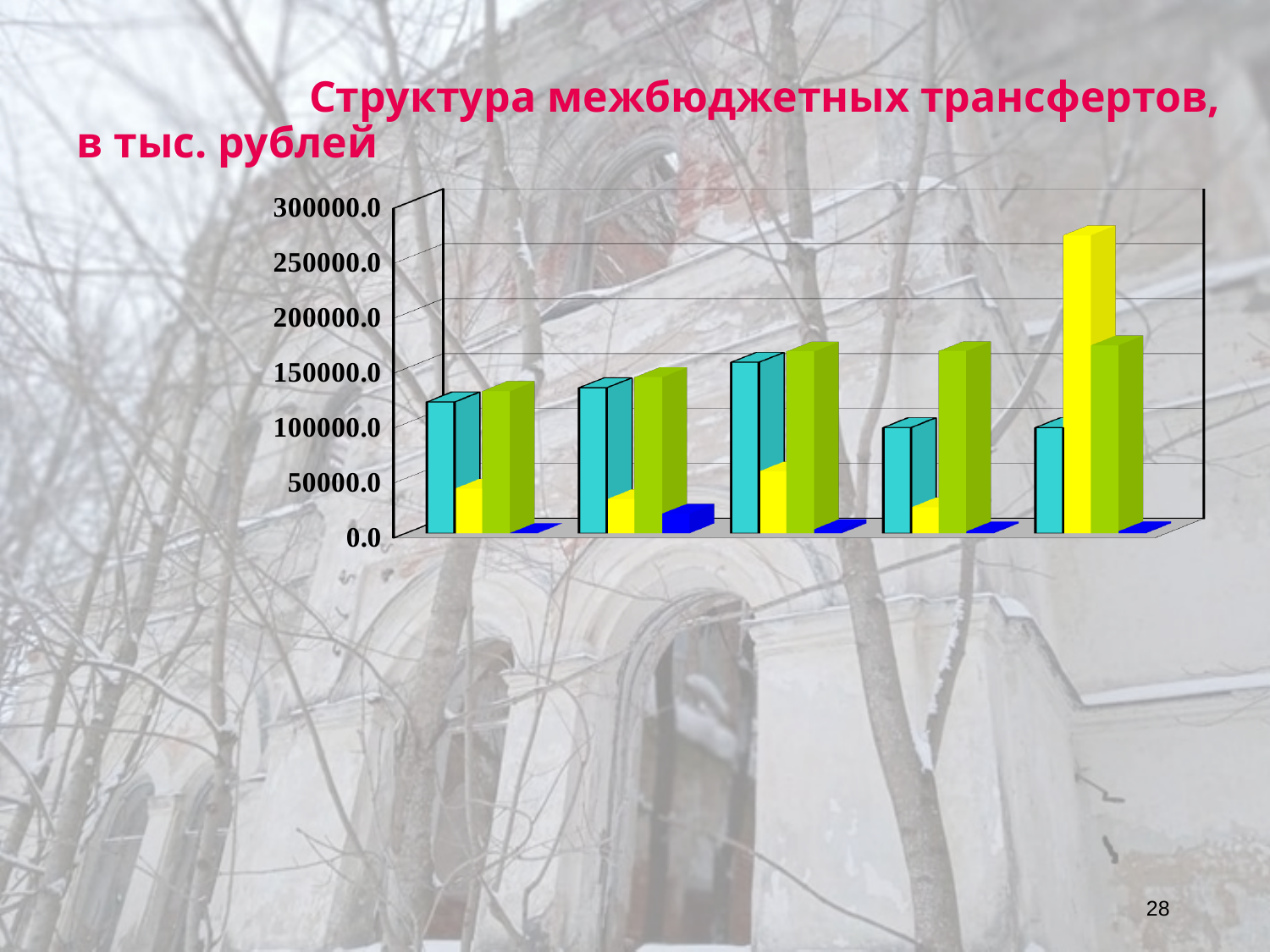
How many groups of bars are plotted in the chart? 5 What kind of chart is shown on the slide? bar chart What is the highest value labelled on the vertical axis of the chart? 300000.0 In the rightmost group, which bar is taller: the yellow bar or the green bar? the yellow bar Is the value of the yellow bar in the leftmost group greater or less than 100000? less Is the value of the cyan bar in the fourth group from the left greater or less than 150000? less Is the value of the yellow bar in the rightmost group greater or less than 250000? greater How many bars are there in each group of the chart? 4 What is the title of the chart on the slide? Структура межбюджетных трансфертов, в тыс. рублей In the leftmost group, which bar is taller: the cyan bar or the yellow bar? the cyan bar Which group of bars contains the tallest bar in the chart? the rightmost (fifth) group